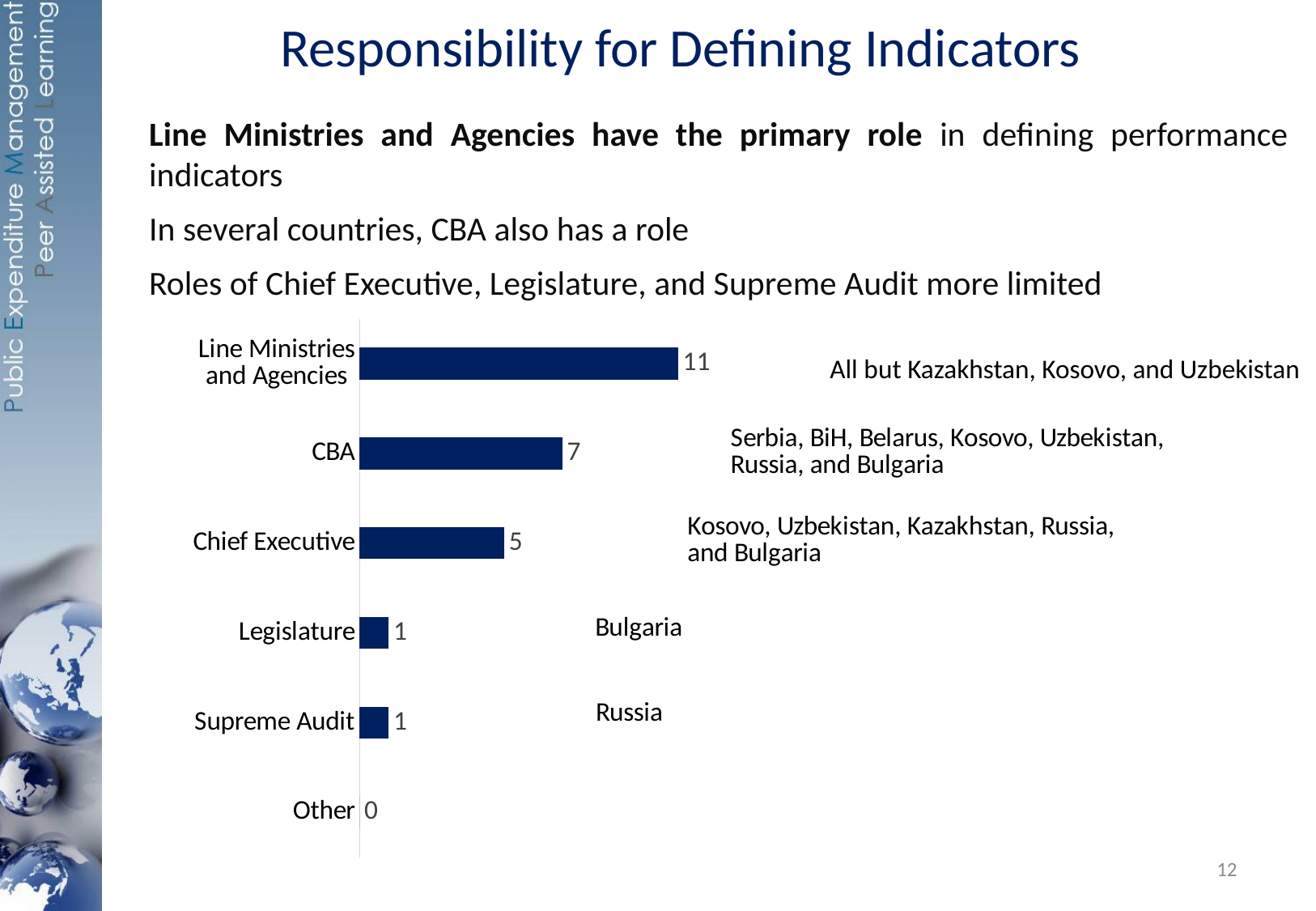
Which countries are listed next to the Chief Executive bar? Kosovo, Uzbekistan, Kazakhstan, Russia, and Bulgaria What is the value for Chief Executive? 5 How many categories are shown in the chart? 6 Which is larger, the value for Chief Executive or the value for Legislature? Chief Executive What is the value for Line Ministries and Agencies? 11 What kind of chart is shown on the slide? Bar chart What is the value for CBA? 7 What is the value for Other? 0 Which category has the highest value? Line Ministries and Agencies Which category has the lowest value? Other What is the difference between the values for Line Ministries and Agencies and CBA? 4 What is the difference between the values for CBA and Chief Executive? 2